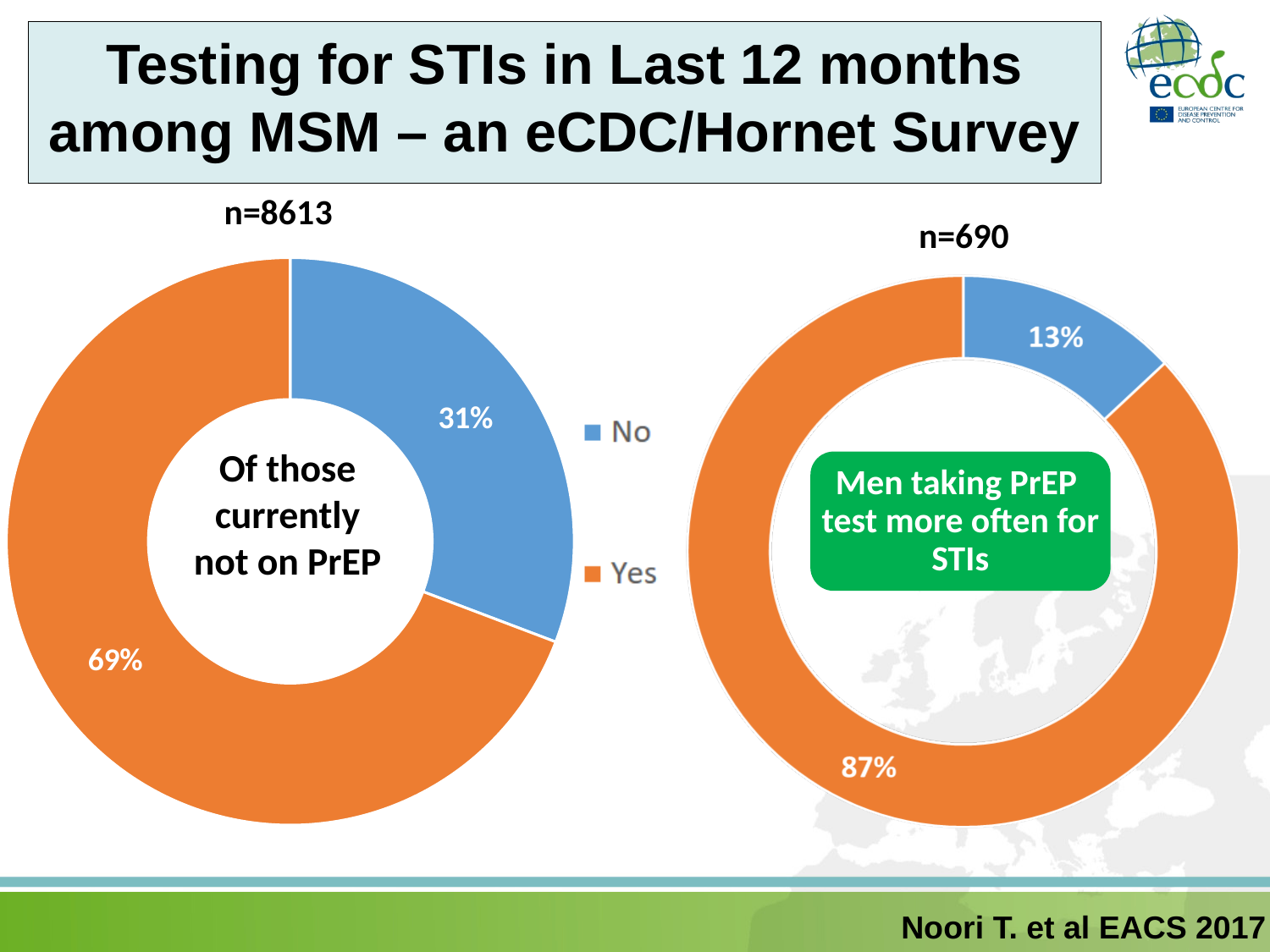
On the left chart (n=8613, those currently not on PrEP), what percentage answered No? 31% On the left chart (n=8613), what is the difference in percentage points between the Yes and No shares? 38 percentage points Which colour represents the Yes category in the legend? Orange On the right chart (n=690), which category has the smallest share? No On the left chart (n=8613), which category has the larger share, Yes or No? Yes How many categories does the legend between the two charts list? 2 On the left chart (n=8613, those currently not on PrEP), what percentage answered Yes? 69% What is the sample size (n) shown above the right chart? n=690 What type of chart is used on the left side of the slide? Pie (donut) chart On the right chart (n=690, men taking PrEP), what percentage answered No? 13% What is the difference in percentage points between the Yes share on the right chart (87%) and the Yes share on the left chart (69%)? 18 percentage points On the right chart (n=690, men taking PrEP), what percentage answered Yes? 87%